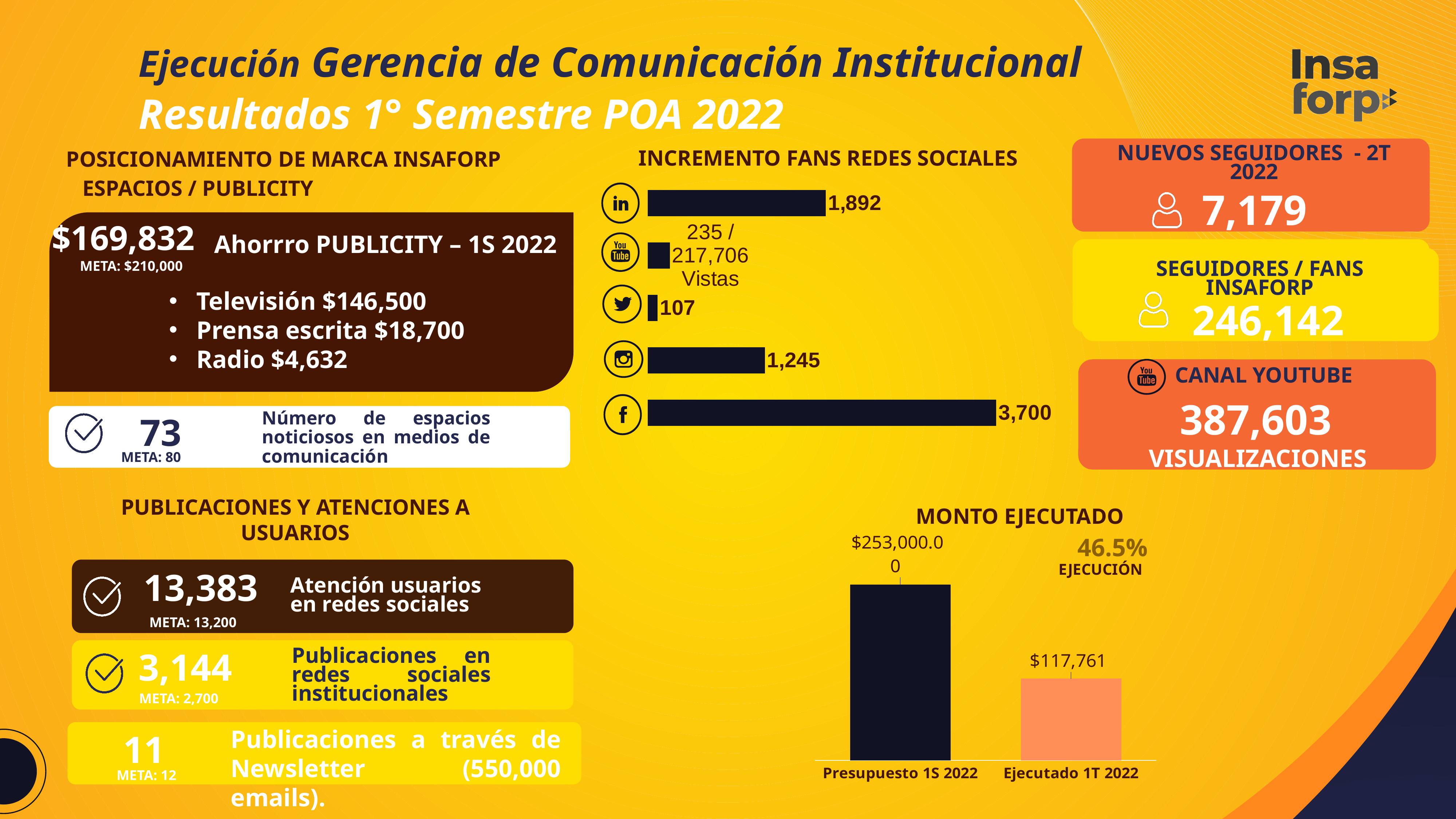
In the MONTO EJECUTADO chart, which bar is taller, Presupuesto 1S 2022 or Ejecutado 1T 2022? Presupuesto 1S 2022 In the INCREMENTO FANS REDES SOCIALES chart, what is the value for the Twitter bar? 107 In the INCREMENTO FANS REDES SOCIALES chart, which social network has the longest bar? Facebook In the INCREMENTO FANS REDES SOCIALES chart, what is the difference between the Facebook value and the LinkedIn value? 1,808 In the MONTO EJECUTADO chart, what is the value for Ejecutado 1T 2022? $117,761 In the MONTO EJECUTADO chart, what execution percentage is shown next to the Ejecutado 1T 2022 bar? 46.5% How many bars are in the MONTO EJECUTADO chart? 2 In the MONTO EJECUTADO chart, what is the value for Presupuesto 1S 2022? $253,000.00 In the INCREMENTO FANS REDES SOCIALES chart, what is the value for the LinkedIn bar? 1,892 In the INCREMENTO FANS REDES SOCIALES chart, what is the value for the Facebook bar? 3,700 What kind of chart is the MONTO EJECUTADO chart? bar chart In the INCREMENTO FANS REDES SOCIALES chart, which social network has the shortest bar? Twitter